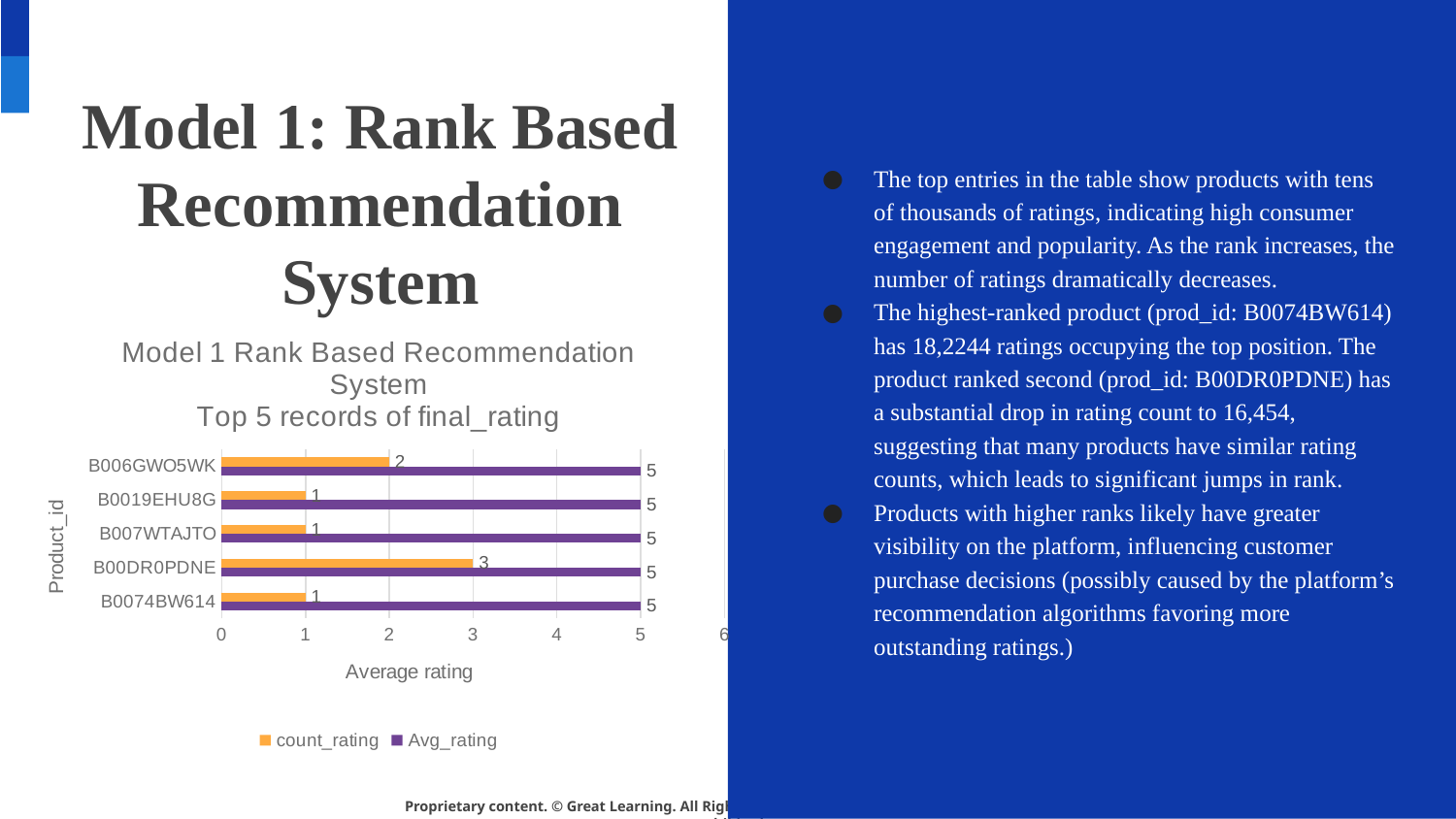
What is the difference between the count_rating values of B00DR0PDNE and B006GWO5WK? 1 What is the count_rating value for B00DR0PDNE? 3 How many product IDs are plotted on the chart? 5 What is the count_rating value for B006GWO5WK? 2 Which is larger, the count_rating for B006GWO5WK or the count_rating for B0019EHU8G? B006GWO5WK What kind of chart is shown on the slide? bar chart What is the label of the horizontal axis of the chart? Average rating How many series does the chart legend list? 2 What is the difference between the Avg_rating and count_rating values for B0074BW614? 4 What is the Avg_rating value for B0074BW614? 5 Which product has the highest count_rating value? B00DR0PDNE Which series is shown in orange in the chart legend? count_rating